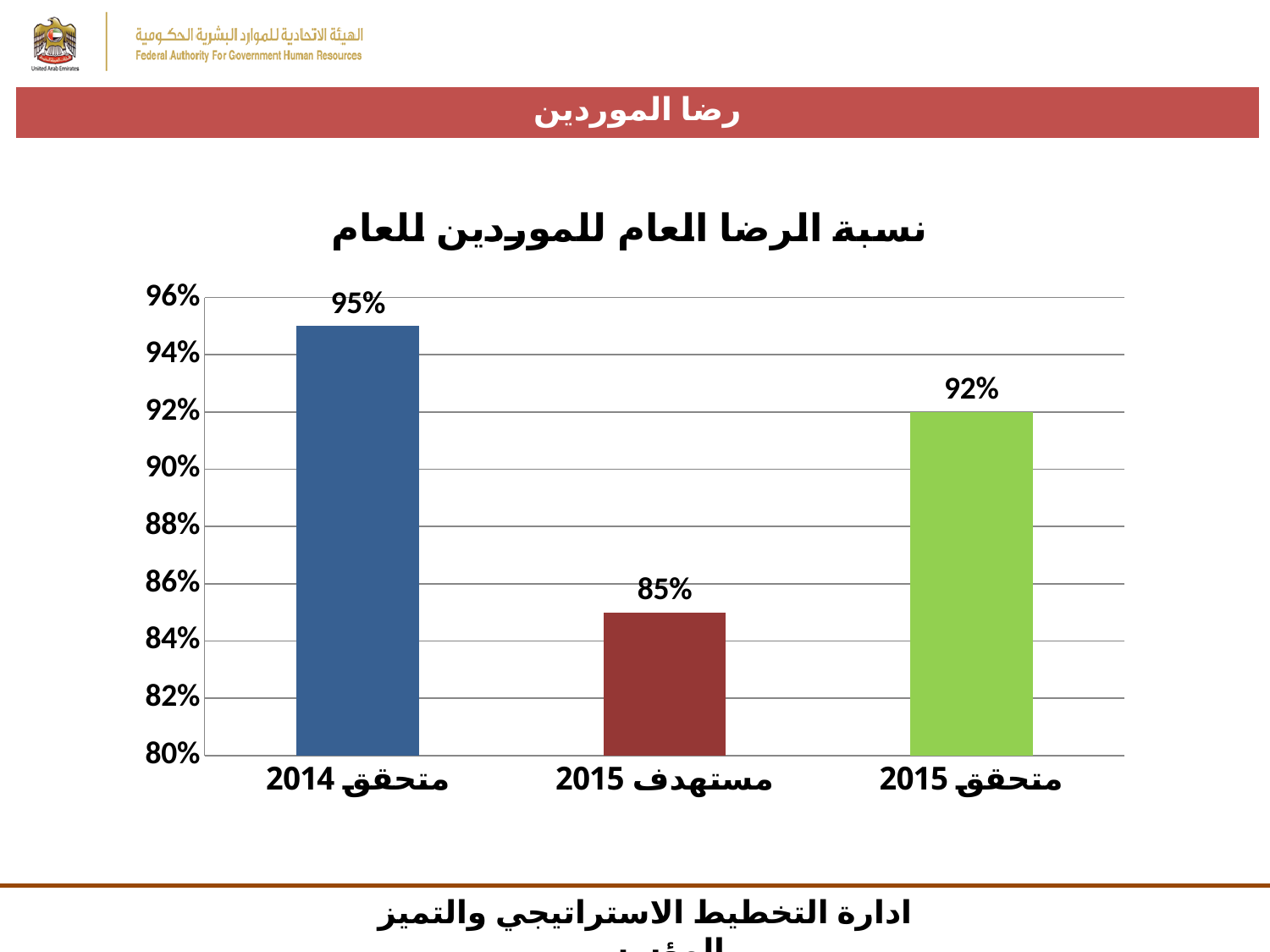
What is the value for مستهدف 2015? 85% What is the title of the chart? نسبة الرضا العام للموردين للعام What is the value for متحقق 2015? 92% Which is larger, متحقق 2015 or مستهدف 2015? متحقق 2015 What is the difference between متحقق 2015 and مستهدف 2015? 7% How many categories are shown in the chart? 3 Which category has the lowest value? مستهدف 2015 Which category has the highest value? متحقق 2014 What is the value for متحقق 2014? 95% Is the value for مستهدف 2015 greater or less than 90%? less What is the difference between متحقق 2014 and متحقق 2015? 3% What kind of chart is shown on the slide? bar chart